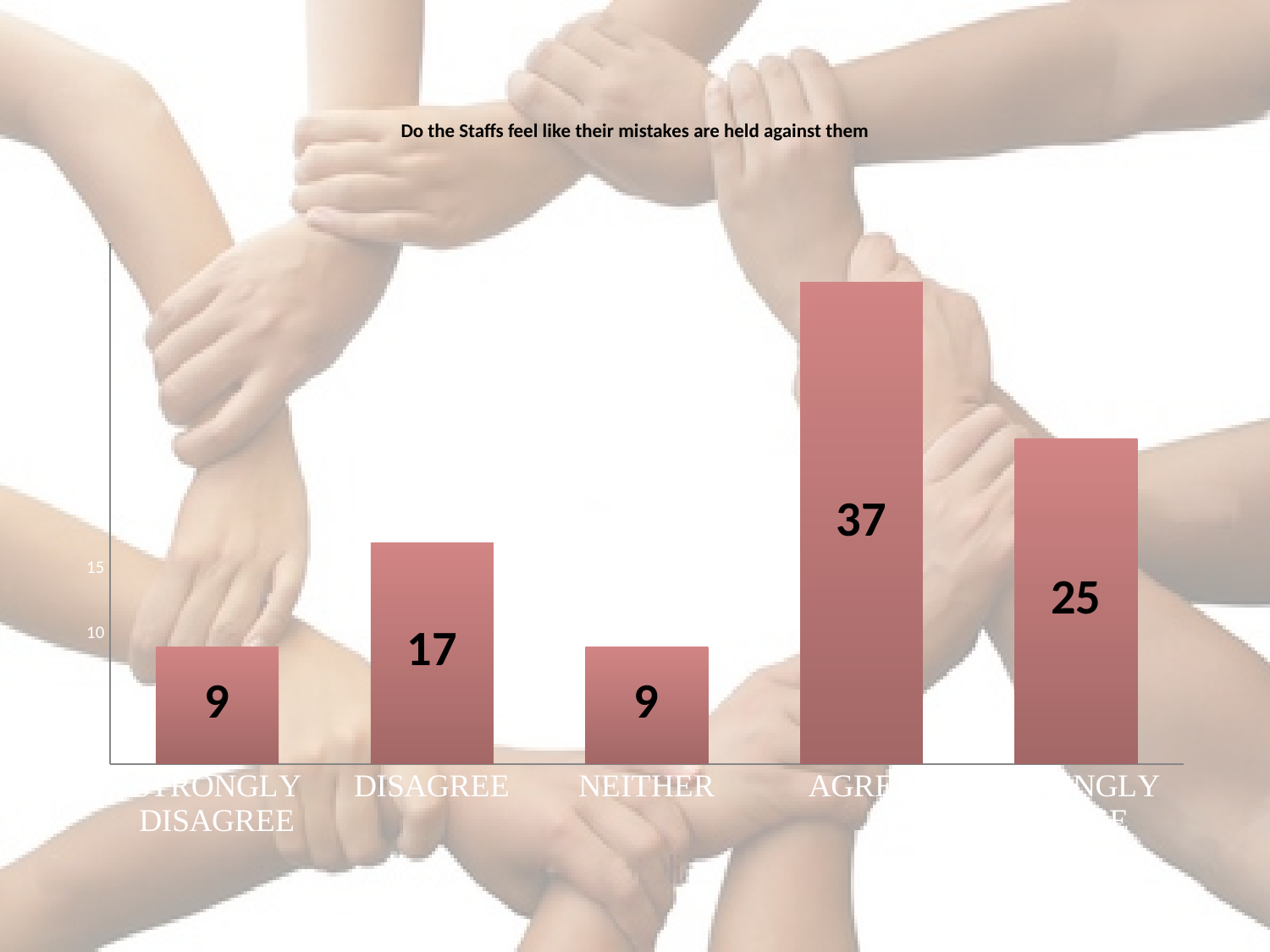
What is the difference between the values for Disagree and Neither? 8 What is the difference between the values for Agree and Strongly Agree? 12 What is the value for Disagree? 17 What is the title of the chart? Do the Staffs feel like their mistakes are held against them Is the value for Strongly Disagree greater or less than 10? less Which category has the highest value? Agree Which is larger, the value for Disagree or the value for Strongly Agree? Strongly Agree What is the value for Neither? 9 How many categories are shown on the x axis? 5 What is the value for Agree? 37 What is the value for Strongly Agree? 25 What type of chart is shown on the slide? Bar chart